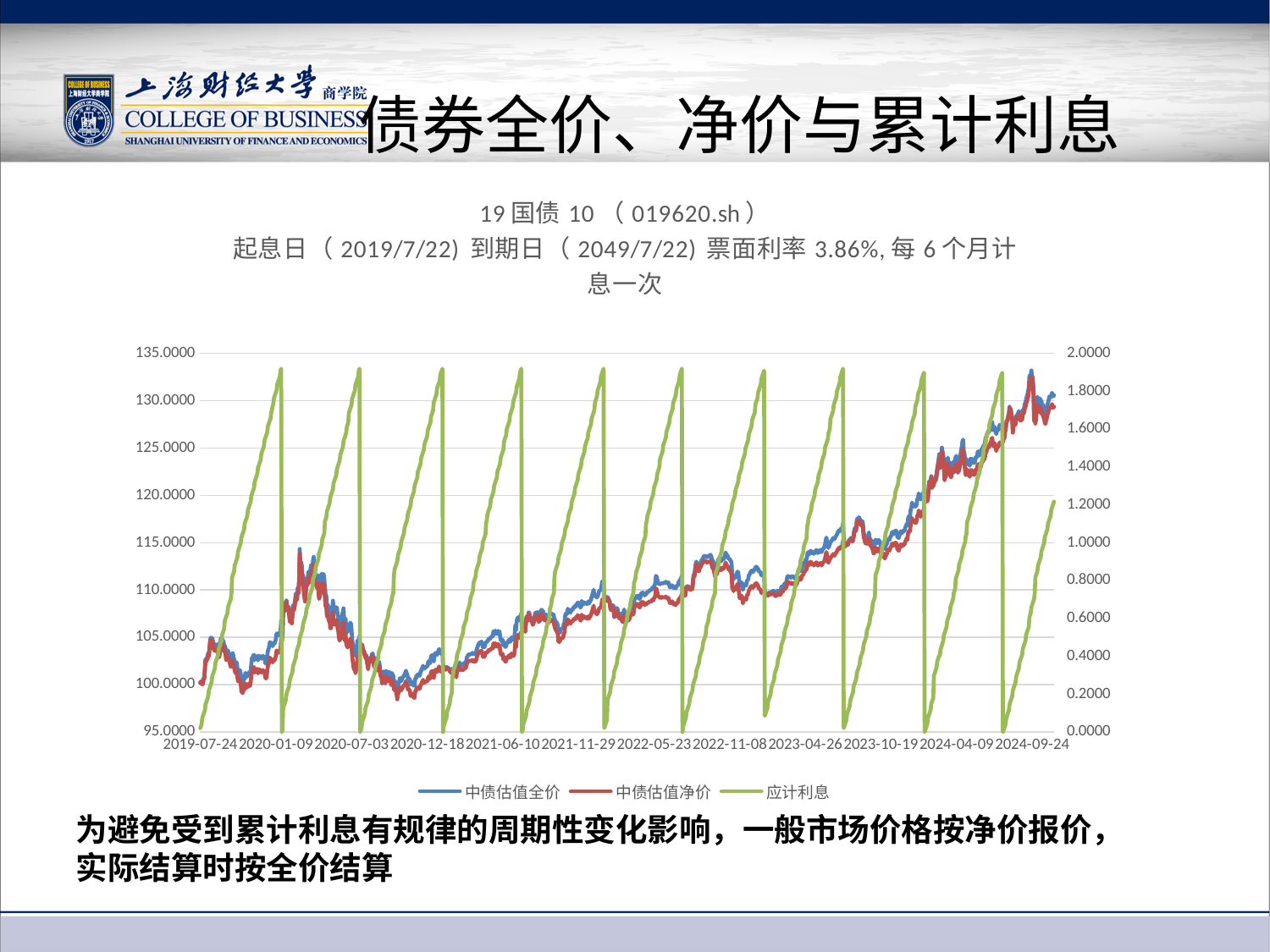
Is the value of 中债估值净价 at 2020-12-18 greater or less than 105.0000? less How many date labels are shown along the x axis? 12 What kind of chart is shown on the slide? line chart What is the first date label on the x axis? 2019-07-24 Is the value of 中债估值全价 at 2024-09-24 greater or less than 120.0000? greater At 2024-04-09, which is larger, 中债估值全价 or 中债估值净价? 中债估值全价 Over the whole period from 2019-07-24 to 2024-09-24, does the 中债估值全价 series generally rise or fall? rise What is the title of the chart (the bond name shown above the plot)? 19 国债 10 （ 019620.sh ） What is the last date label on the x axis? 2024-09-24 Is the value of 中债估值全价 at 2023-10-19 greater or less than 110.0000? greater Which series is plotted in green? 应计利息 How many series does the chart legend list? 3